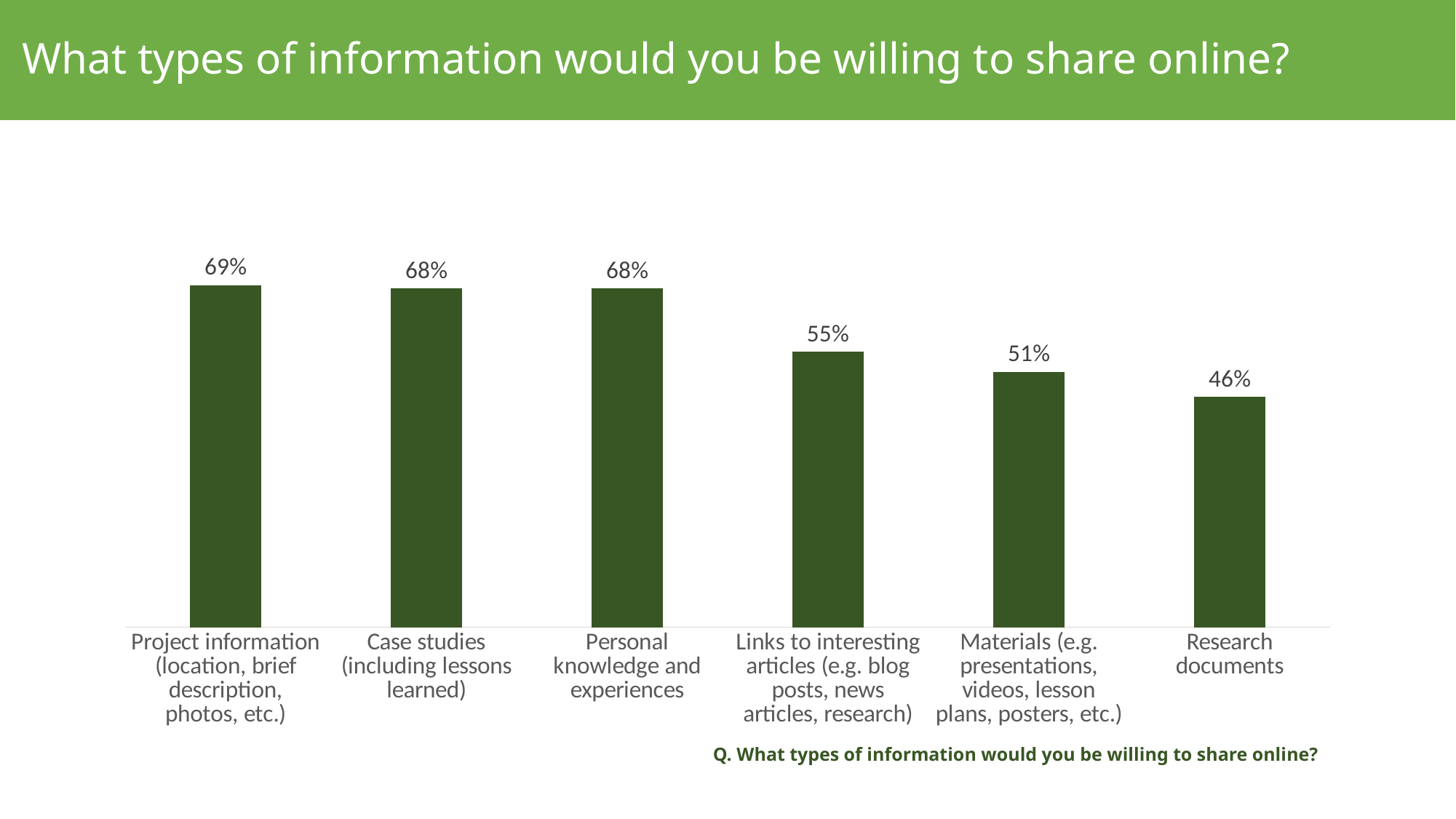
How many types of information are shown on the chart? 6 What percentage would be willing to share research documents online? 46% Which is larger: the value for personal knowledge and experiences or the value for research documents? Personal knowledge and experiences What percentage would share links to interesting articles (e.g. blog posts, news articles, research)? 55% What kind of chart is shown on the slide? Bar chart Which type of information has the highest value on the chart? Project information (location, brief description, photos, etc.) What is the difference between the value for project information and the value for research documents? 23% What is the value for case studies (including lessons learned)? 68% Which type of information has the lowest share of respondents willing to share it? Research documents What is the difference between the values for links to interesting articles and materials? 4% What percentage of respondents would be willing to share project information (location, brief description, photos, etc.) online? 69% What is the value for materials (e.g. presentations, videos, lesson plans, posters, etc.)? 51%